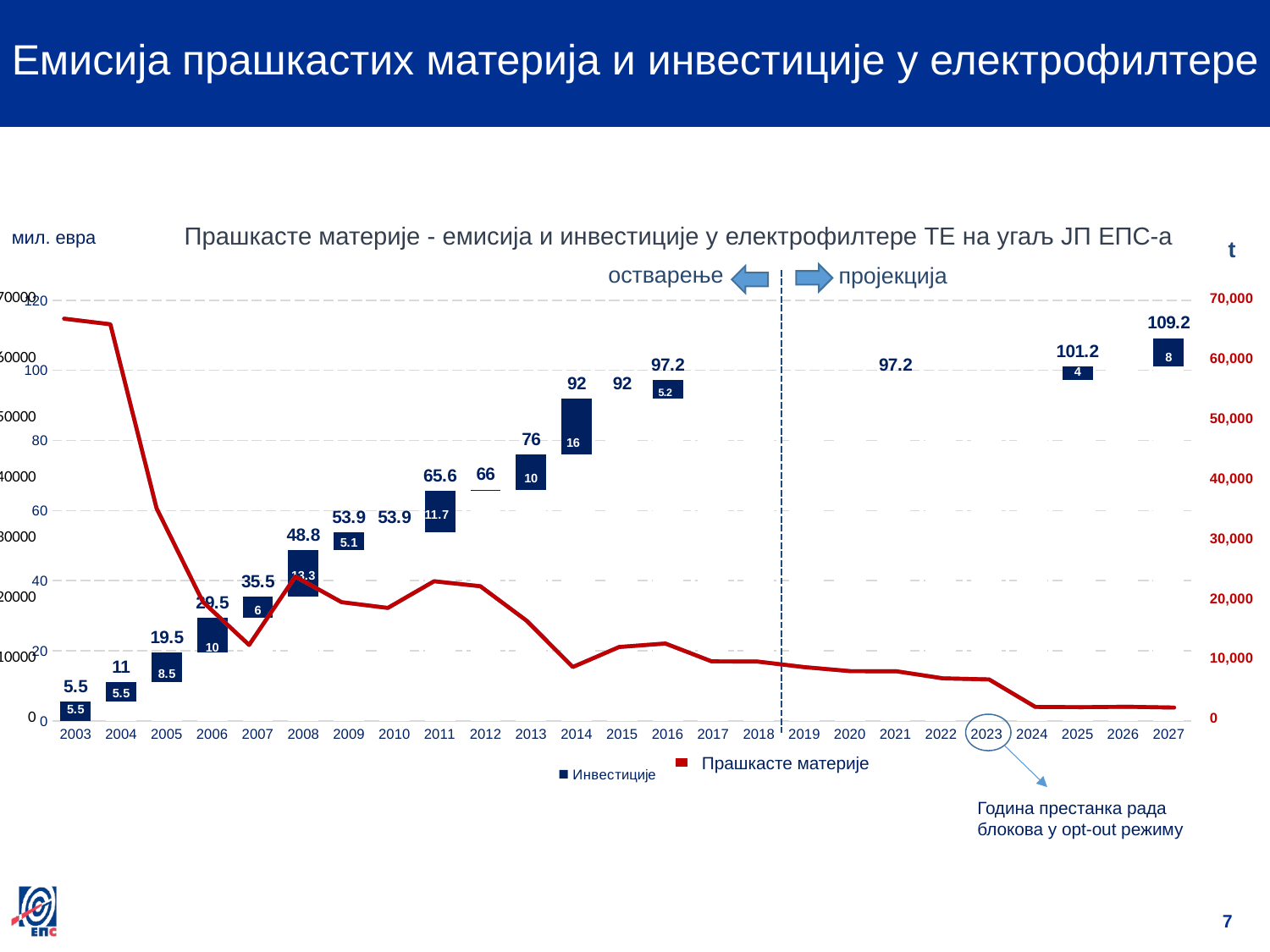
What is the difference between the cumulative investment labels for 2027 and 2025? 8 Which year has the highest cumulative investment label? 2027 What is the cumulative investment value labelled for 2027? 109.2 How many series does the legend list? 2 How many years are shown on the x axis? 25 What value is printed inside the investment bar segment for 2008? 13.3 Which year has the larger cumulative investment label, 2013 or 2011? 2013 Does the dust emission line generally rise or fall from 2003 to 2027? Fall Is the dust emission (Прашкасте материје) value for 2003 greater or less than 60,000 t? greater What kind of chart is shown on the slide? Combined bar and line chart Is the dust emission (Прашкасте материје) value for 2014 greater or less than 10,000 t? less What is the cumulative investment value labelled above the bar for 2014? 92